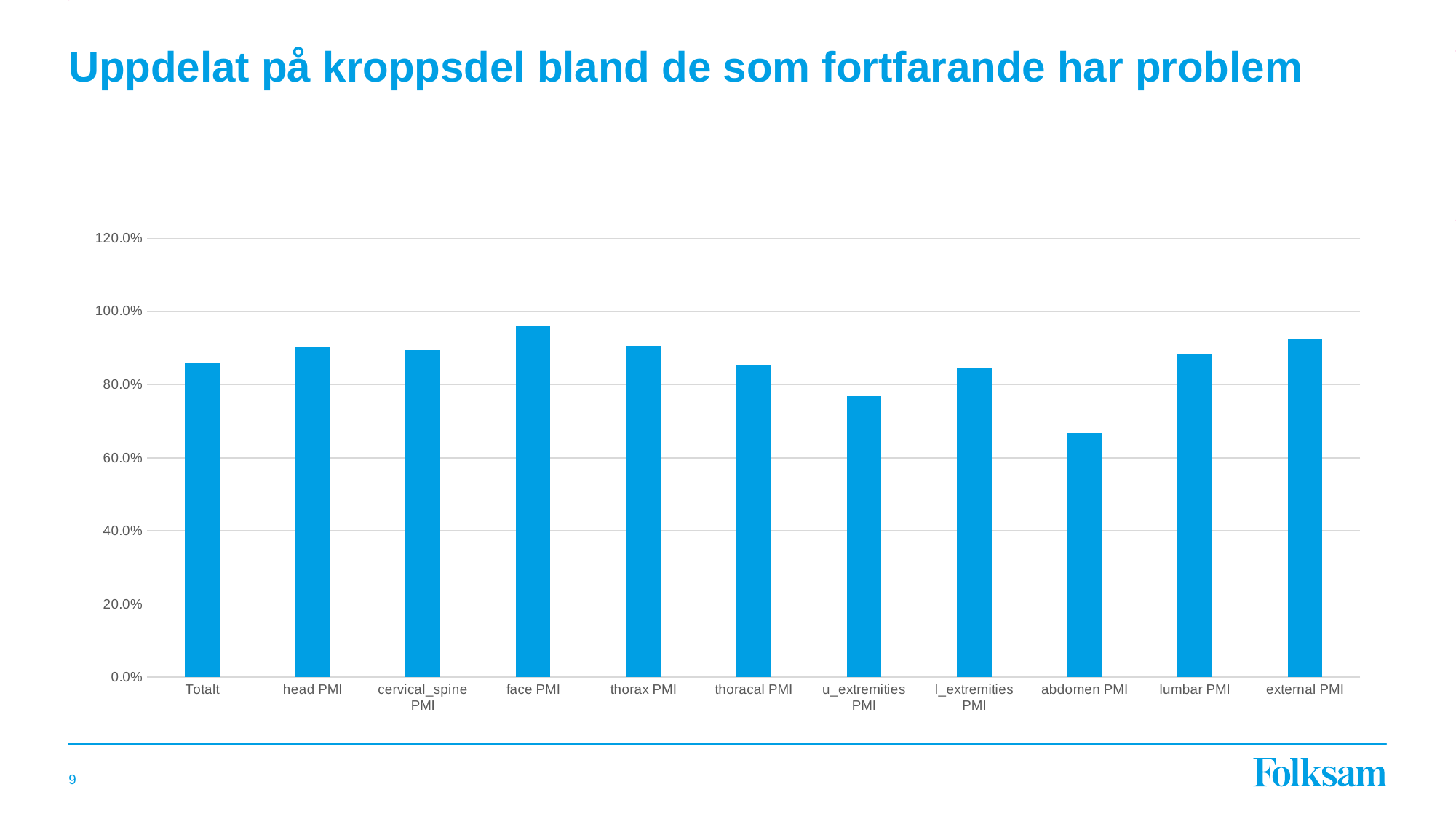
What type of chart is shown on the slide? bar chart Is the value for u_extremities PMI greater or less than 80.0%? less Is the value for face PMI greater or less than 80.0%? greater What is the highest value shown on the y axis of the chart? 120.0% Which is larger, the value for u_extremities PMI or the value for lumbar PMI? lumbar PMI How many categories are shown on the x axis of the chart? 11 Which category has the highest value in the chart? face PMI What is the title of the slide containing the chart? Uppdelat på kroppsdel bland de som fortfarande har problem Is the value for abdomen PMI greater or less than 60.0%? greater Which is larger, the value for abdomen PMI or the value for u_extremities PMI? u_extremities PMI Which category has the lowest value in the chart? abdomen PMI